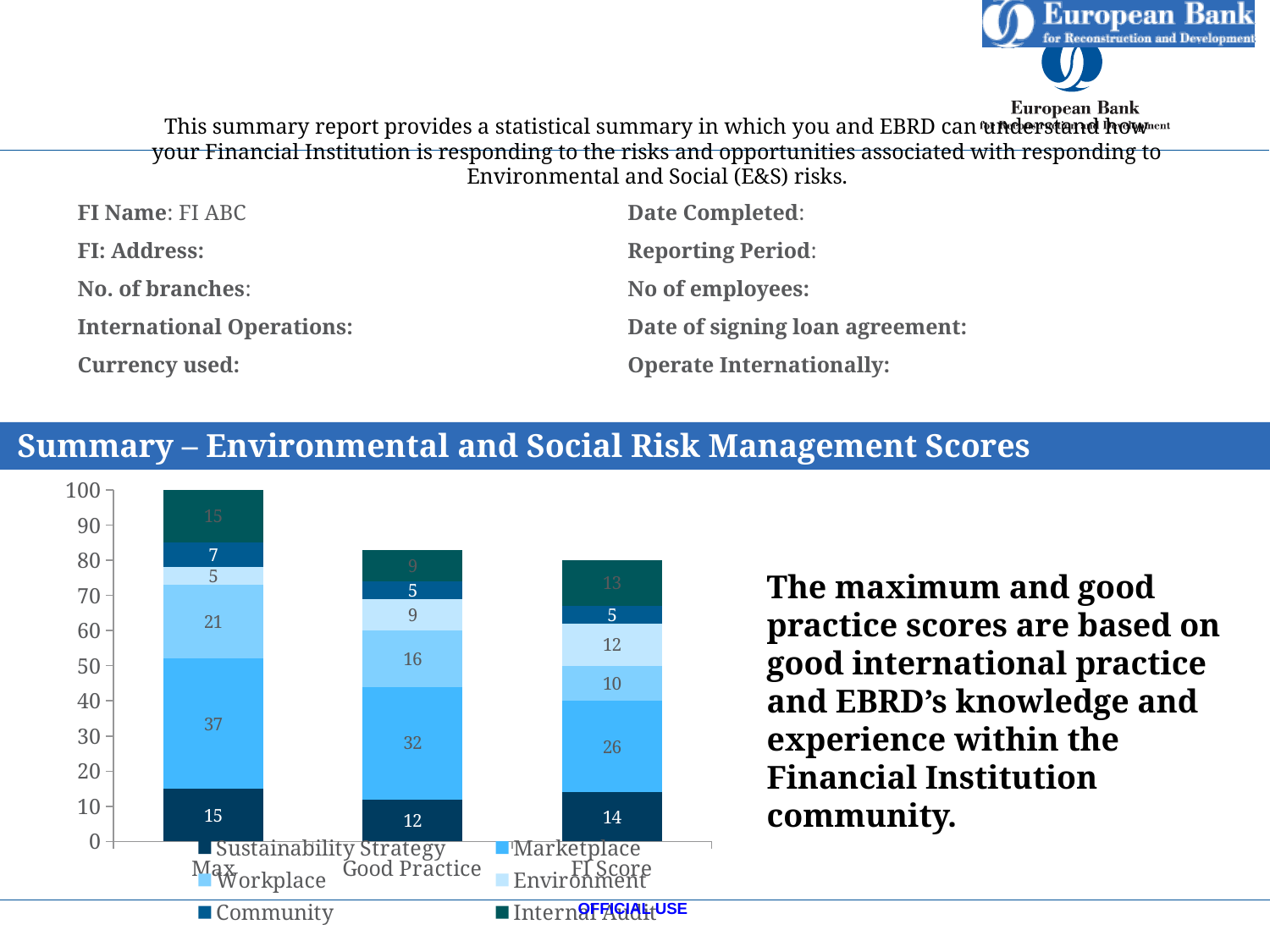
What is the Workplace value for the Good Practice bar? 16 What is the total of the Good Practice stacked bar? 83 Which category has the highest total stacked bar? Max What is the difference between the Marketplace values for Max and FI Score? 11 What kind of chart is shown on the slide? Stacked bar chart Which is larger, the Workplace value for Max or the Workplace value for FI Score? Max Which category has the lowest total stacked bar? FI Score What is the Environment value for the FI Score bar? 12 How many series does the legend list? 6 What is the Marketplace value for the Max bar? 37 What is the total of the FI Score stacked bar? 80 What is the Sustainability Strategy value for the Good Practice bar? 12